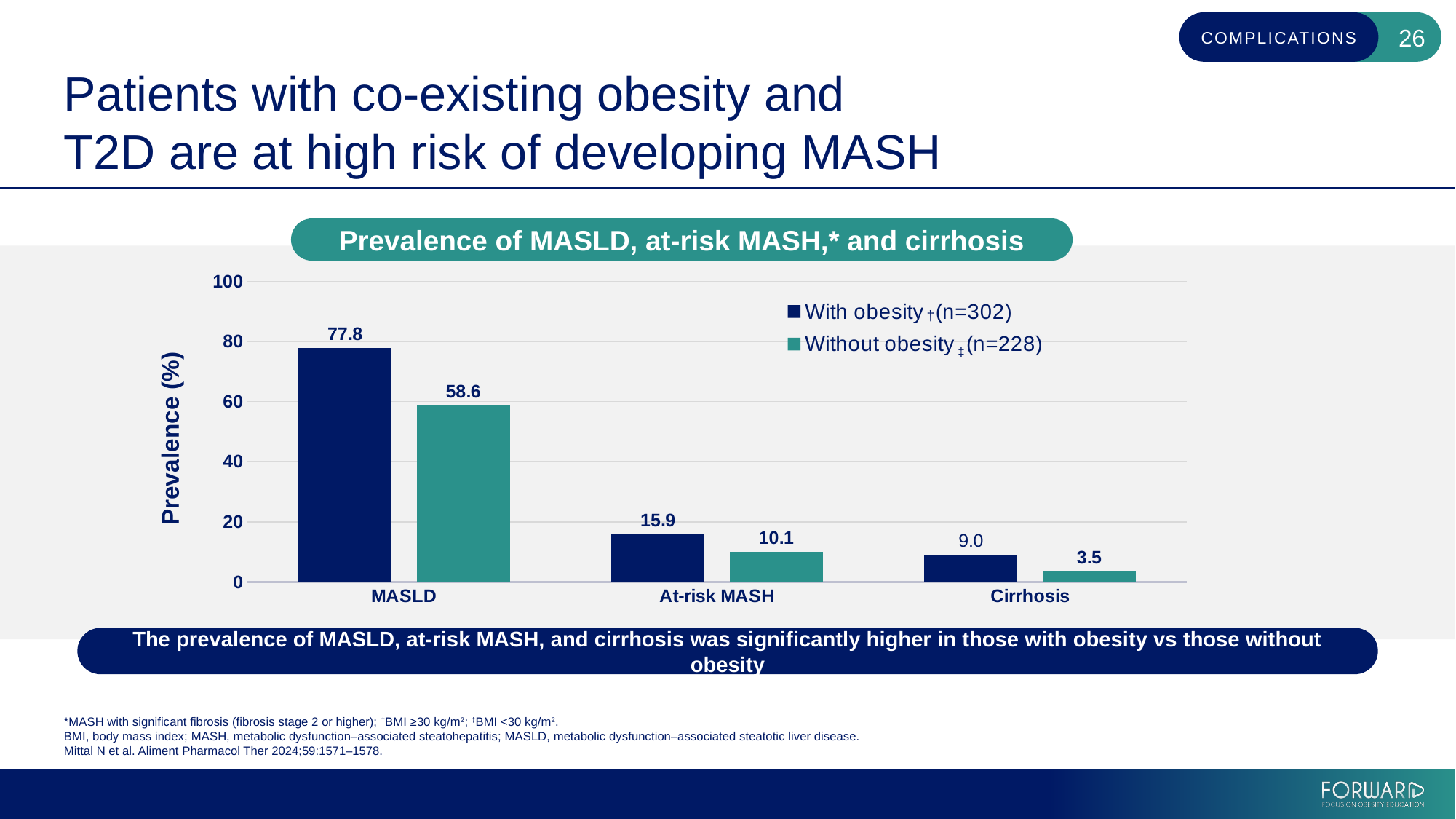
What type of chart is shown on the slide? Bar chart What is the prevalence of MASLD in patients with obesity? 77.8 How many categories are shown on the x axis? 3 Which category has the highest prevalence for the 'With obesity' series? MASLD Is the prevalence of MASLD without obesity greater or less than 60? less What is the prevalence of at-risk MASH in patients without obesity? 10.1 Which category has the lowest prevalence for the 'Without obesity' series? Cirrhosis What is the prevalence of cirrhosis in patients without obesity? 3.5 How many series does the legend list? 2 What is the difference in at-risk MASH prevalence between patients with obesity and without obesity? 5.8 What is the difference in MASLD prevalence between patients with obesity and without obesity? 19.2 Which is larger: the prevalence of cirrhosis with obesity or the prevalence of at-risk MASH without obesity? At-risk MASH without obesity